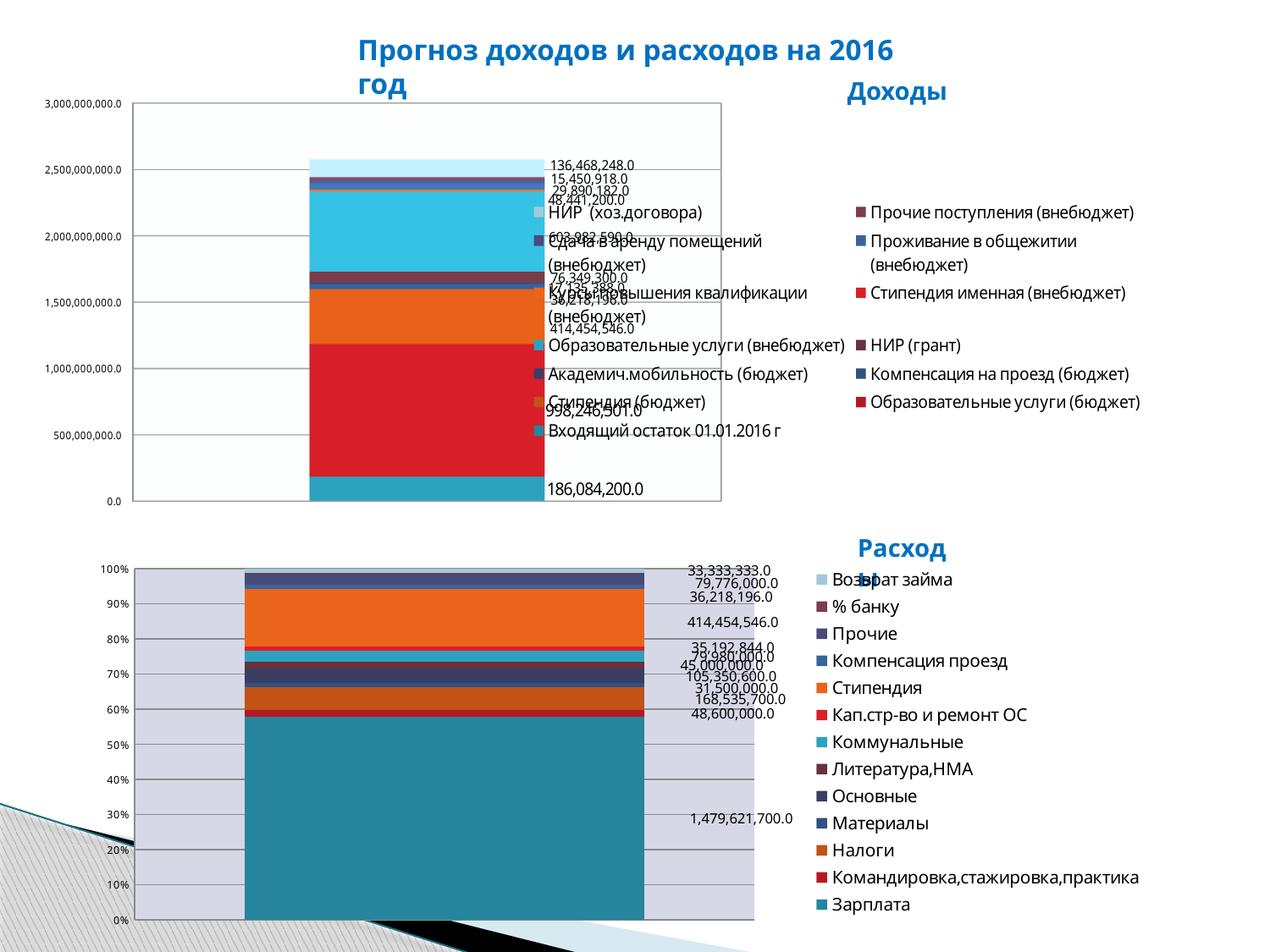
In the bottom chart (Расход), what is the value for Стипендия? 414,454,546.0 What kind of chart is the top chart (Доходы)? stacked bar chart In the top chart (Доходы), which series has the largest value? Образовательные услуги (бюджет) In the bottom chart (Расход), which expense category is the largest? Зарплата In the top chart (Доходы), what is the difference between Образовательные услуги (бюджет) and Стипендия (бюджет)? 583,791,955.0 How many series does the legend of the top chart (Доходы) list? 13 In the top chart (Доходы), what is the value for Входящий остаток 01.01.2016 г? 186,084,200.0 In the top chart (Доходы), what is the value for Образовательные услуги (бюджет)? 998,246,501.0 In the top chart (Доходы), which is larger: Образовательные услуги (внебюджет) or Стипендия (бюджет)? Образовательные услуги (внебюджет) In the bottom chart (Расход), is the share of Зарплата greater or less than 50%? greater In the bottom chart (Расход), what is the value for Зарплата? 1,479,621,700.0 In the top chart (Доходы), is the total height of the stacked bar greater or less than 2,500,000,000.0? greater